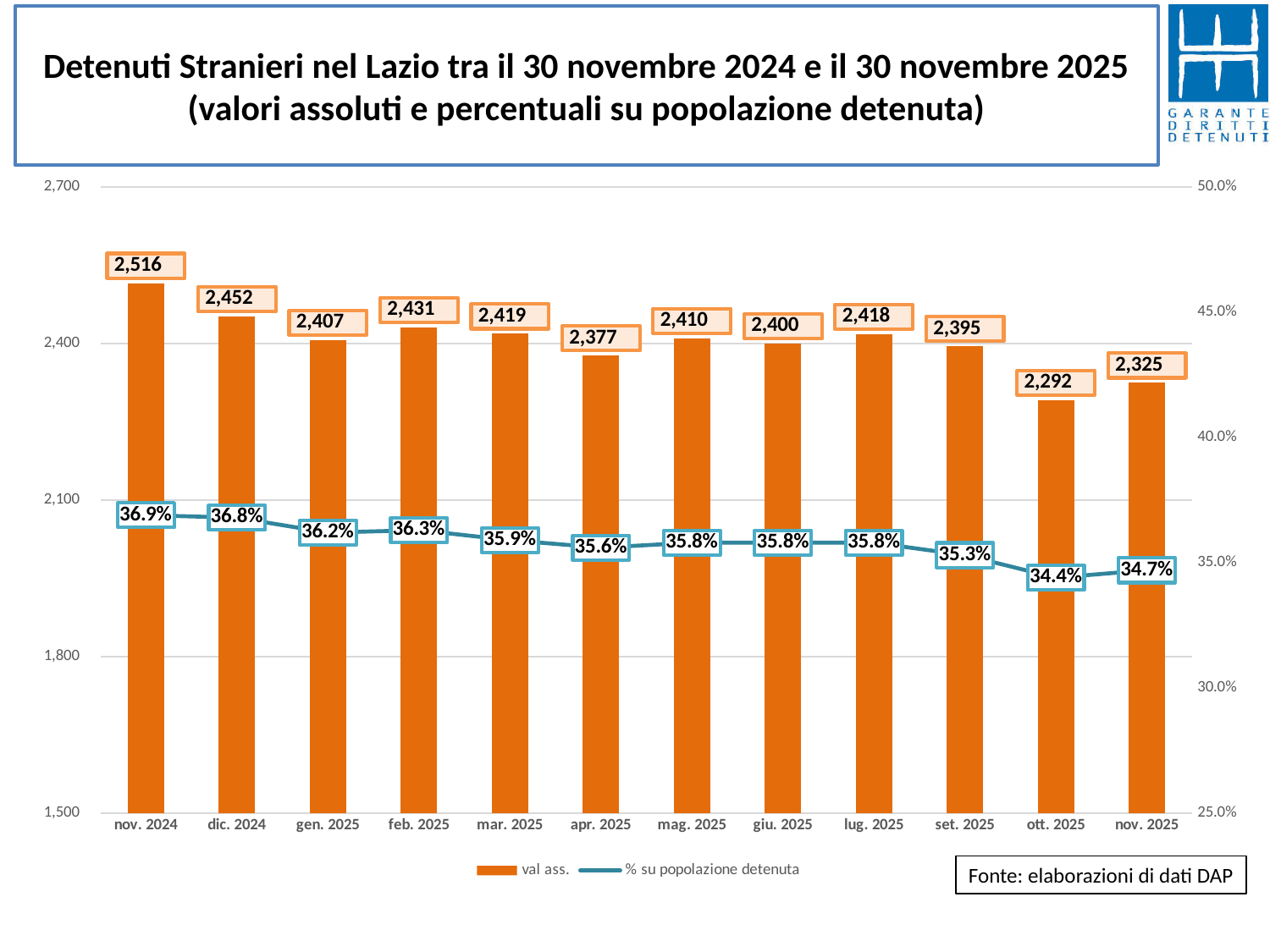
What is the difference in absolute value between nov. 2024 and nov. 2025? 191 How many series does the legend list? 2 What is the percentage of the detained population (% su popolazione detenuta) for ott. 2025? 34.4% What kind of chart is this? Combined bar and line chart Which month has the lowest percentage of the detained population? ott. 2025 Does the percentage of the detained population generally rise or fall from nov. 2024 to nov. 2025? Fall Which month has the highest absolute value (val ass.)? nov. 2024 How many months are shown on the x axis? 12 What is the absolute value (val ass.) for apr. 2025? 2,377 Which is larger, the absolute value for feb. 2025 or for mar. 2025? feb. 2025 What is the absolute value (val ass.) for nov. 2024? 2,516 Which month has the lowest absolute value (val ass.)? ott. 2025